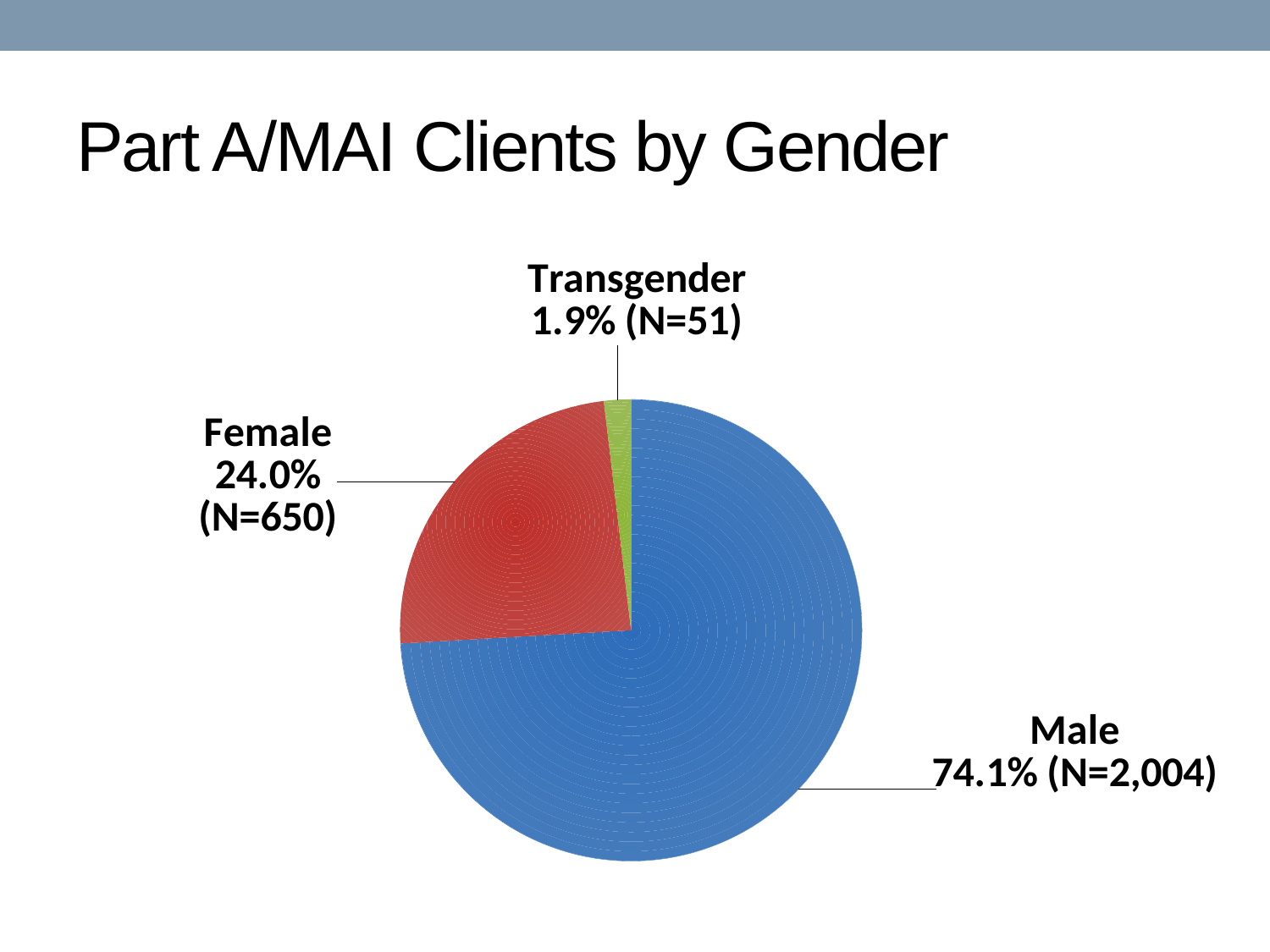
How many gender categories are shown in the pie chart? 3 How many Transgender clients are shown (N)? 51 What percentage of Part A/MAI clients are Female? 24.0% How many Male clients are shown (N)? 2,004 How many Female clients are shown (N)? 650 What percentage of Part A/MAI clients are Male? 74.1% Which gender category has the smallest share of clients? Transgender Which is larger, the Female share or the Transgender share? Female What type of chart is shown on the slide? Pie chart Which gender category has the largest share of clients? Male What percentage of Part A/MAI clients are Transgender? 1.9% What is the difference in percentage points between the Male and Female shares? 50.1